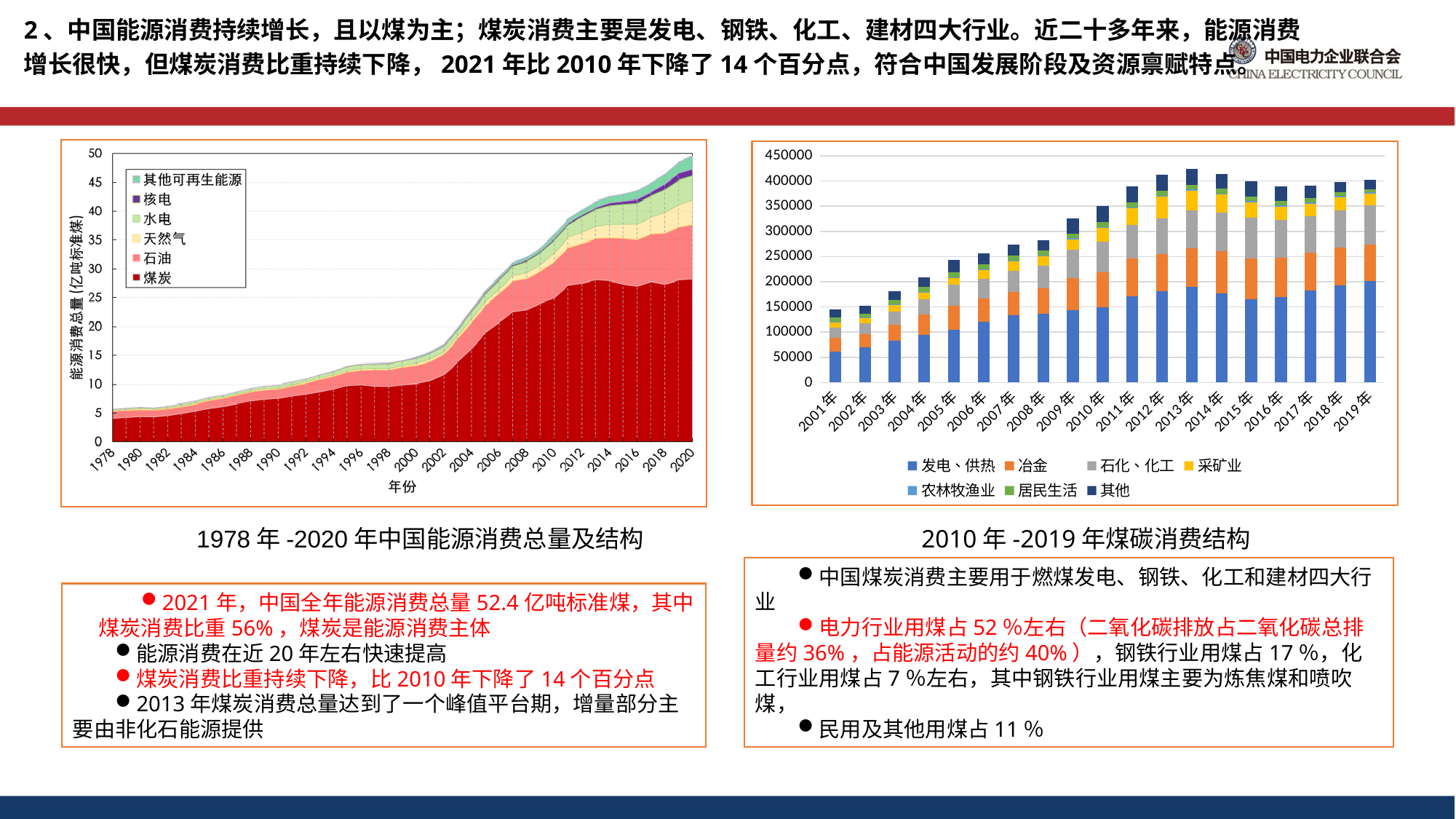
How many years (bars) are shown on the x axis of the right chart? 19 In the right chart, which year has the highest total bar? 2013年 In the right chart, is the total for 2013年 greater or less than 400000? greater How many series does the legend of the left chart list? 6 In the left chart, does total energy consumption rise or fall from 1978 to 2020? rise In the left chart, is the total energy consumption in 2020 greater or less than 45? greater In the right chart, which year has the lowest total bar? 2001年 How many series does the legend of the right chart list? 7 What kind of chart is the right chart (2010年-2019年煤碳消费结构)? stacked bar chart What kind of chart is the left chart (1978年-2020年中国能源消费总量及结构)? stacked area chart In the right chart, which series forms the largest segment of each bar? 发电、供热